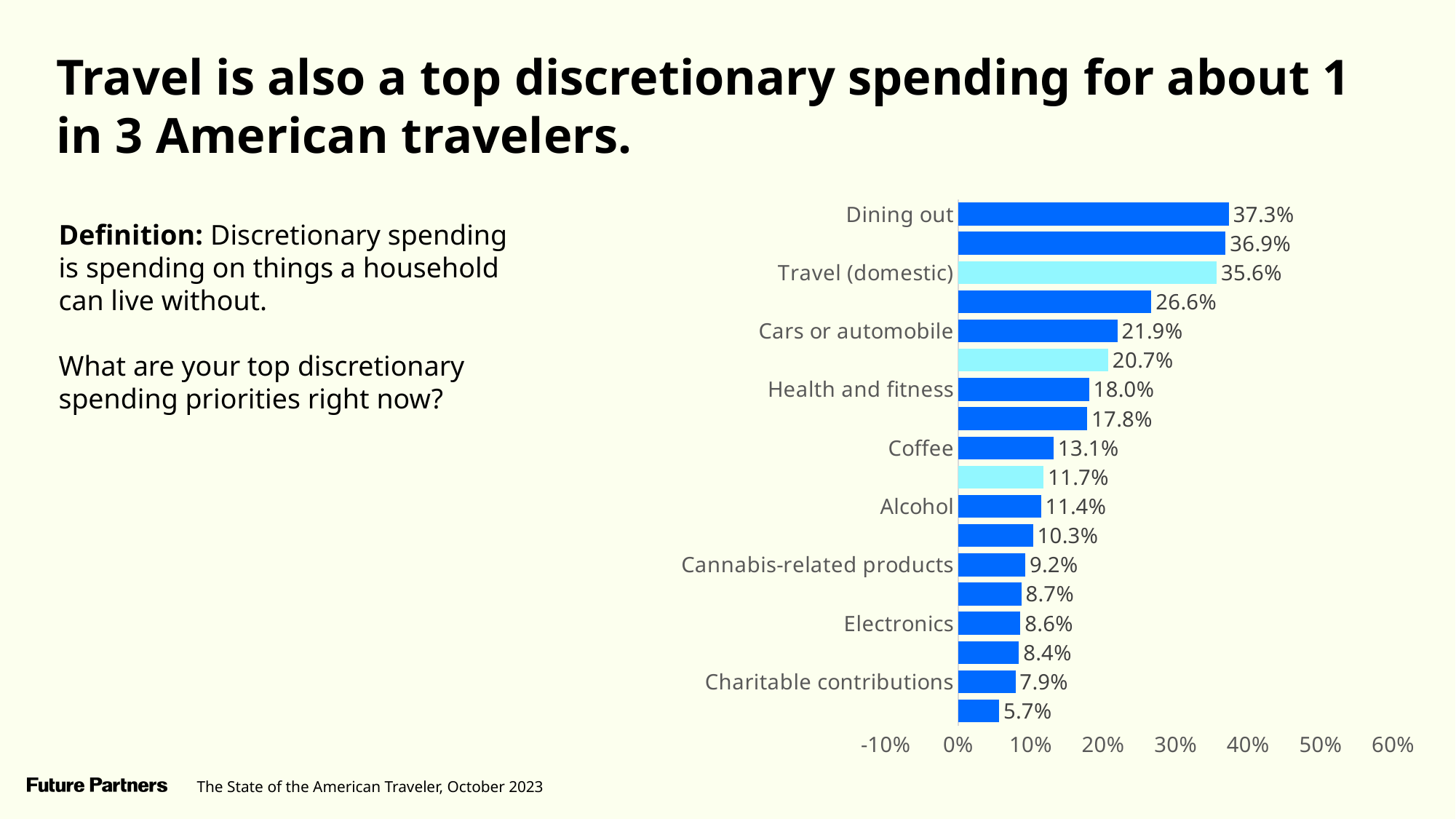
What is the value shown for Cars or automobile? 21.9% Do the bar values increase or decrease from the top of the chart to the bottom? Decrease What percentage of respondents chose Dining out as a top discretionary spending priority? 37.3% What kind of chart is shown on the slide? Bar chart What is the value shown for Charitable contributions? 7.9% What is the smallest value printed on the chart? 5.7% Is the value for Travel (domestic) greater or less than 30%? greater Which labeled category has the highest value in the chart? Dining out What is the value shown for Travel (domestic)? 35.6% What is the difference between the values for Cars or automobile and Health and fitness? 3.9 percentage points Which has a larger value, Coffee or Alcohol? Coffee What is the difference between the values for Dining out and Travel (domestic)? 1.7 percentage points